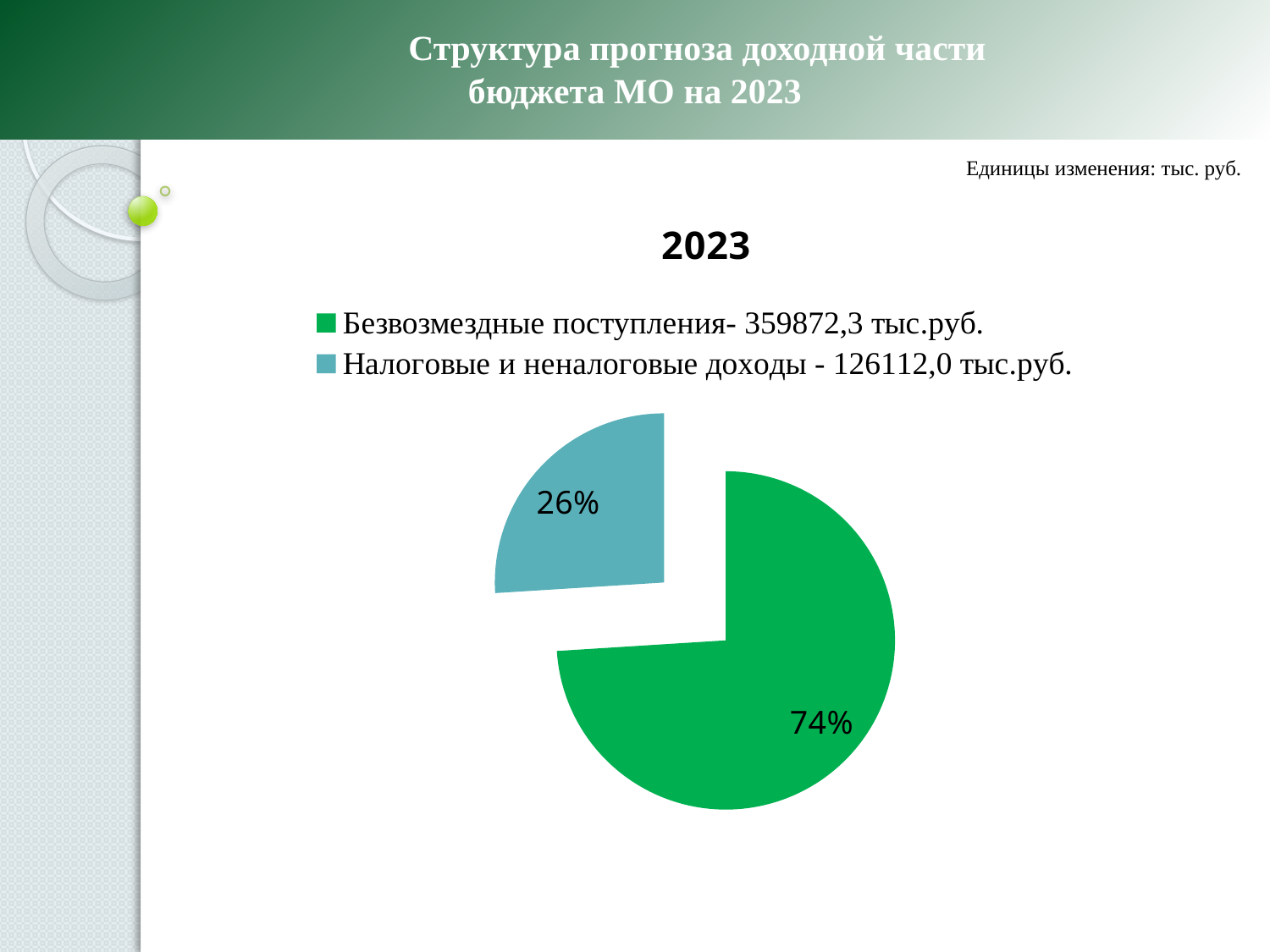
Which category has the largest slice of the pie? Безвозмездные поступления What share of the pie does Безвозмездные поступления take? 74% What share of the pie does Налоговые и неналоговые доходы take? 26% Which category has the smallest slice of the pie? Налоговые и неналоговые доходы What is the title of the chart? 2023 What colour is the slice for Налоговые и неналоговые доходы? teal (blue-green) What value is given in the legend for Безвозмездные поступления? 359872,3 тыс.руб. What value is given in the legend for Налоговые и неналоговые доходы? 126112,0 тыс.руб. How many slices does the pie chart have? 2 What kind of chart is shown on the slide? pie chart By how many percentage points does the share of Безвозмездные поступления exceed that of Налоговые и неналоговые доходы? 48 How many entries does the legend list? 2